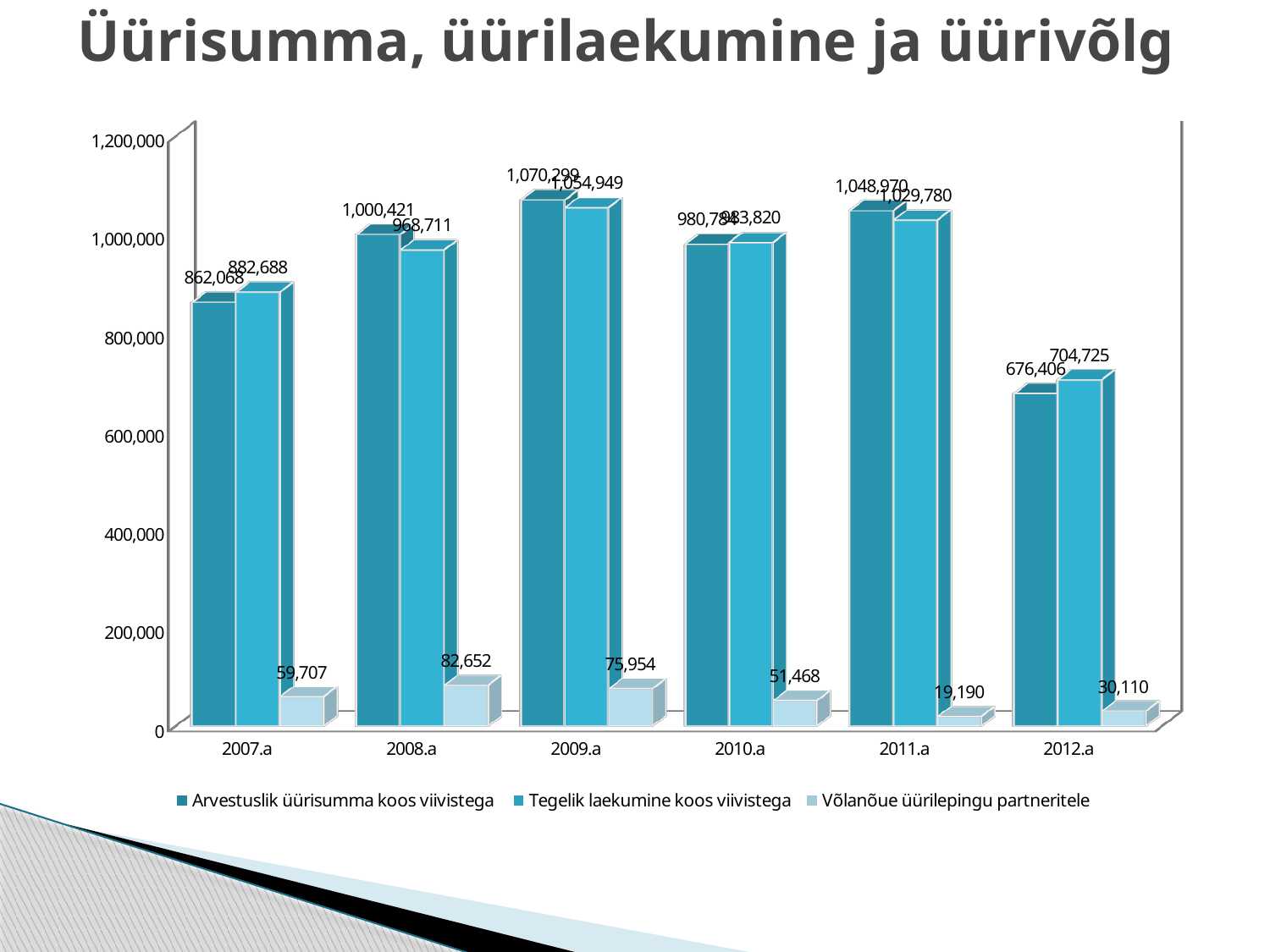
In which year is Arvestuslik üürisumma koos viivistega lowest? 2012.a What is the value of Tegelik laekumine koos viivistega for 2012.a? 704,725 What is the value of Võlanõue üürilepingu partneritele for 2010.a? 51,468 How many series does the legend list? 3 Is the value of Tegelik laekumine koos viivistega for 2012.a greater or less than 800,000? less In which year is Võlanõue üürilepingu partneritele highest? 2008.a How many years are shown on the x axis? 6 What is the difference between Arvestuslik üürisumma koos viivistega and Tegelik laekumine koos viivistega in 2008.a? 31,710 Which is larger in 2012.a: Arvestuslik üürisumma koos viivistega or Tegelik laekumine koos viivistega? Tegelik laekumine koos viivistega What kind of chart is shown on the slide? bar chart In which year is Võlanõue üürilepingu partneritele lowest? 2011.a What is the value of Arvestuslik üürisumma koos viivistega for 2009.a? 1,070,299